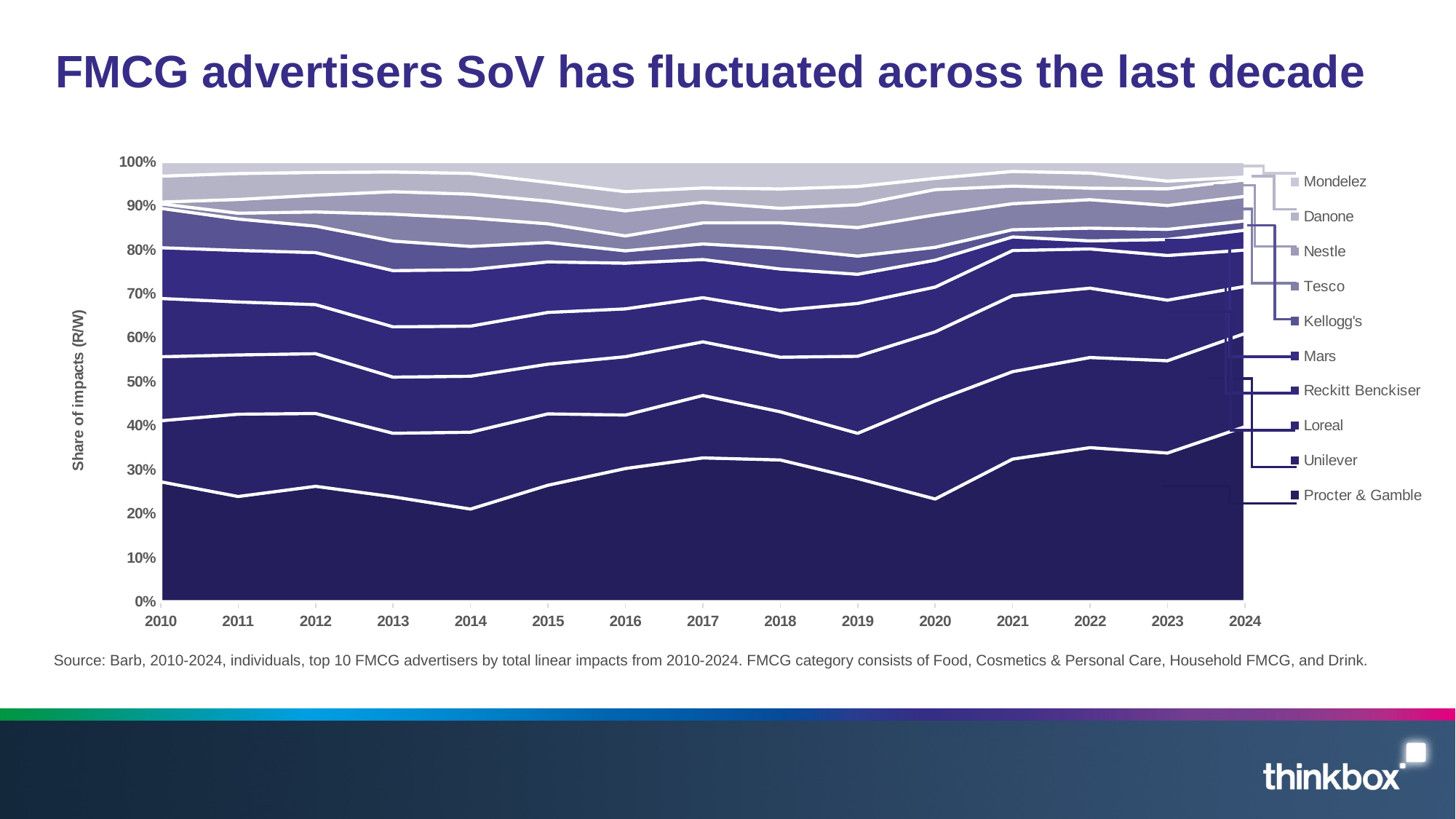
Is the share for Procter & Gamble in 2024 greater or less than 30%? greater What kind of chart is shown on the slide? Stacked area chart What is the label on the y axis? Share of impacts (R/W) Is the share for Procter & Gamble in 2014 greater or less than 30%? less In which year is Procter & Gamble's share highest? 2024 Does Procter & Gamble's share rise or fall from 2017 to 2020? fall How many advertisers does the legend list? 10 How many years are plotted along the x axis? 15 Is Procter & Gamble's share larger in 2010 or in 2024? 2024 Which advertiser is the bottom layer of the stacked area chart? Procter & Gamble Is the share for Procter & Gamble in 2010 greater or less than 20%? greater Does Procter & Gamble's share rise or fall from 2020 to 2024? rise